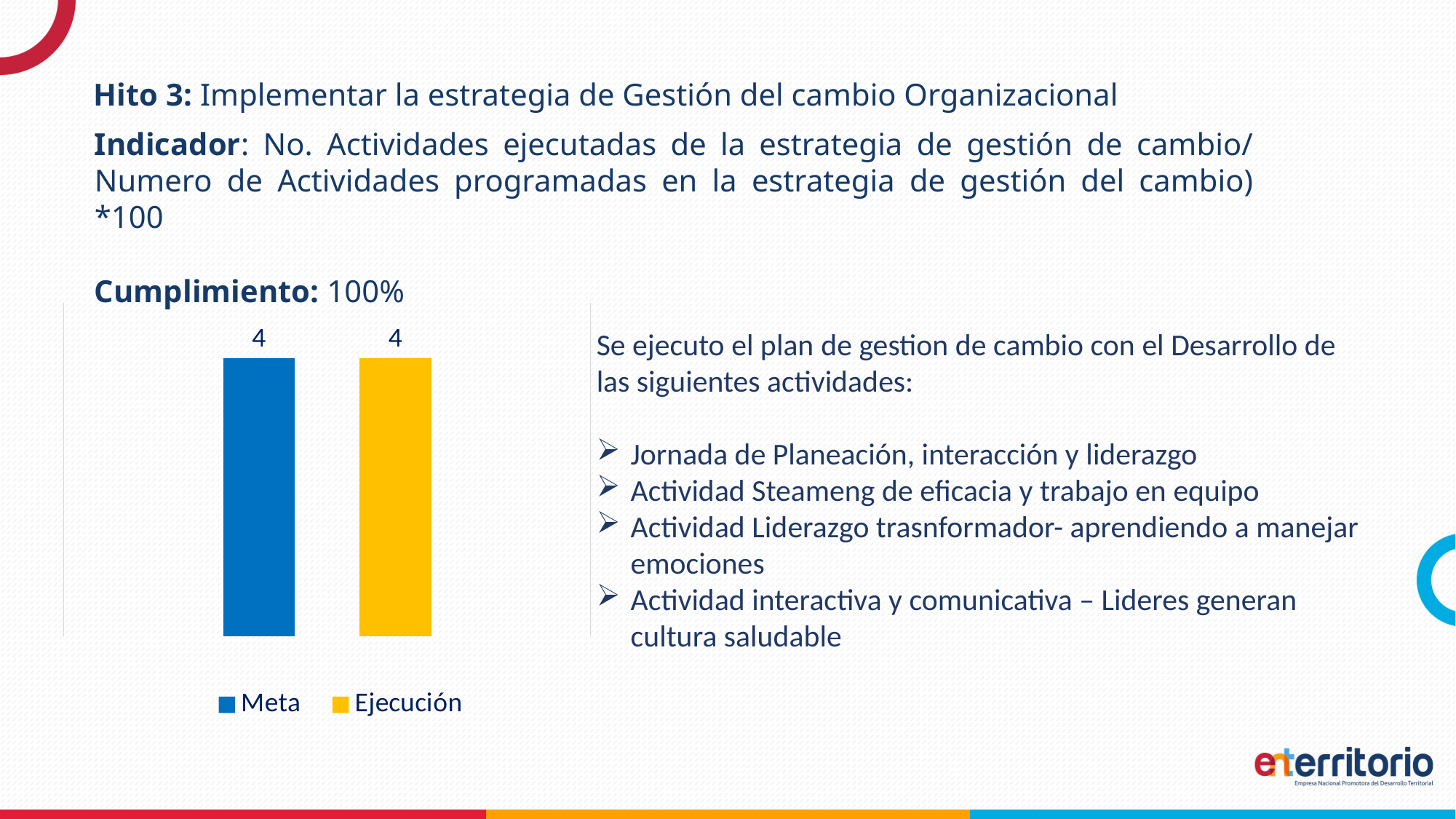
How many series does the legend list? 2 What is the difference between the Meta and Ejecución values? 0 Which legend entry is shown in blue? Meta What is the value of the Meta bar? 4 How many bars are plotted in the chart? 2 What is the total of the Meta and Ejecución values? 8 What kind of chart is shown on the slide? bar chart What is the value of the Ejecución bar? 4 Which legend entry is shown in yellow? Ejecución